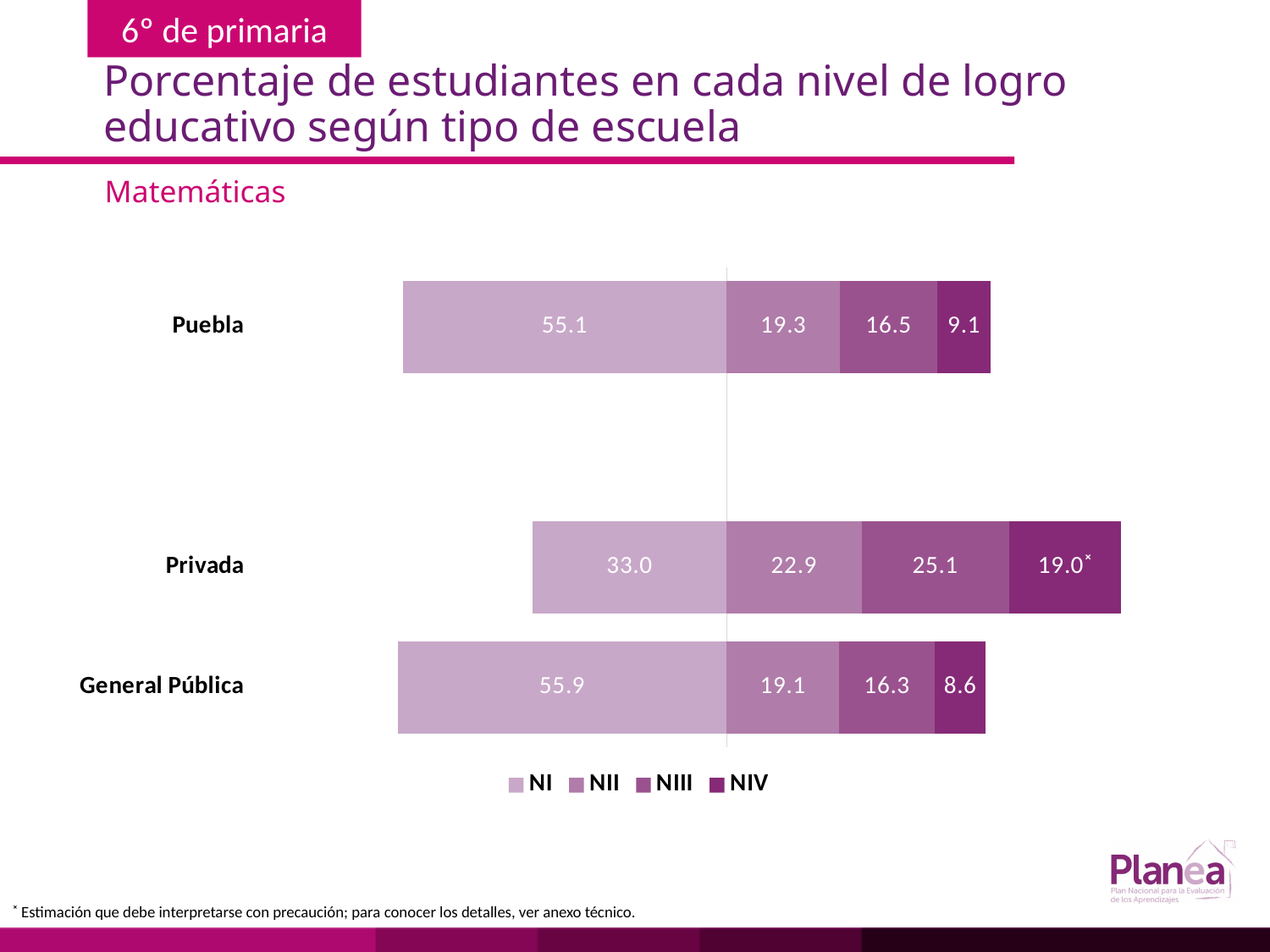
How many school types are shown in the chart? 3 Which is larger, the NIII value for Privada or the NIII value for Puebla? Privada What is the NIII value for General Pública? 16.3 What is the NIV value for Privada? 19.0 Which school type has the highest NI value? General Pública What is the NI value for Puebla? 55.1 What is the total of the stacked bar for Puebla? 100.0 What is the difference between the NI values for General Pública and Privada? 22.9 How many series does the legend list? 4 Which school type has the lowest NIV value? General Pública What kind of chart is shown on the slide? Stacked bar chart What is the NII value for General Pública? 19.1